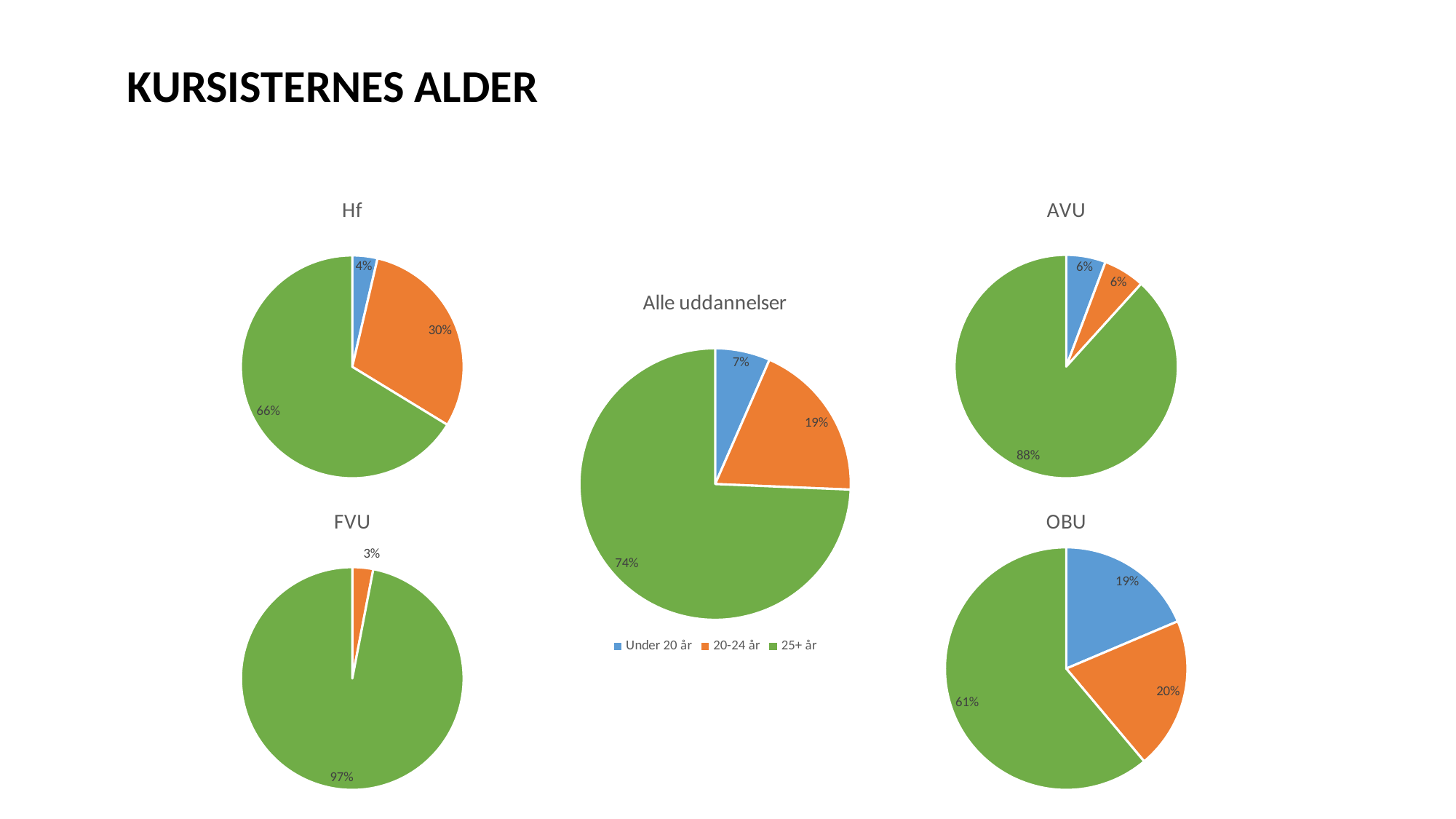
In the "AVU" pie chart, what share is labelled for the 25+ år slice? 88% In the "Alle uddannelser" pie chart, what share is labelled for the Under 20 år slice? 7% What kind of chart is used for "Alle uddannelser"? Pie chart In the "Hf" pie chart, which slice is the largest? 25+ år In the "OBU" pie chart, which is larger, the Under 20 år slice or the 20-24 år slice? 20-24 år In the "Alle uddannelser" pie chart, what share is labelled for the 25+ år slice? 74% How many series does the legend under the "Alle uddannelser" chart list? 3 How many pie charts are shown on the slide? 5 In the "Hf" pie chart, what is the difference between the 25+ år share and the 20-24 år share? 36%